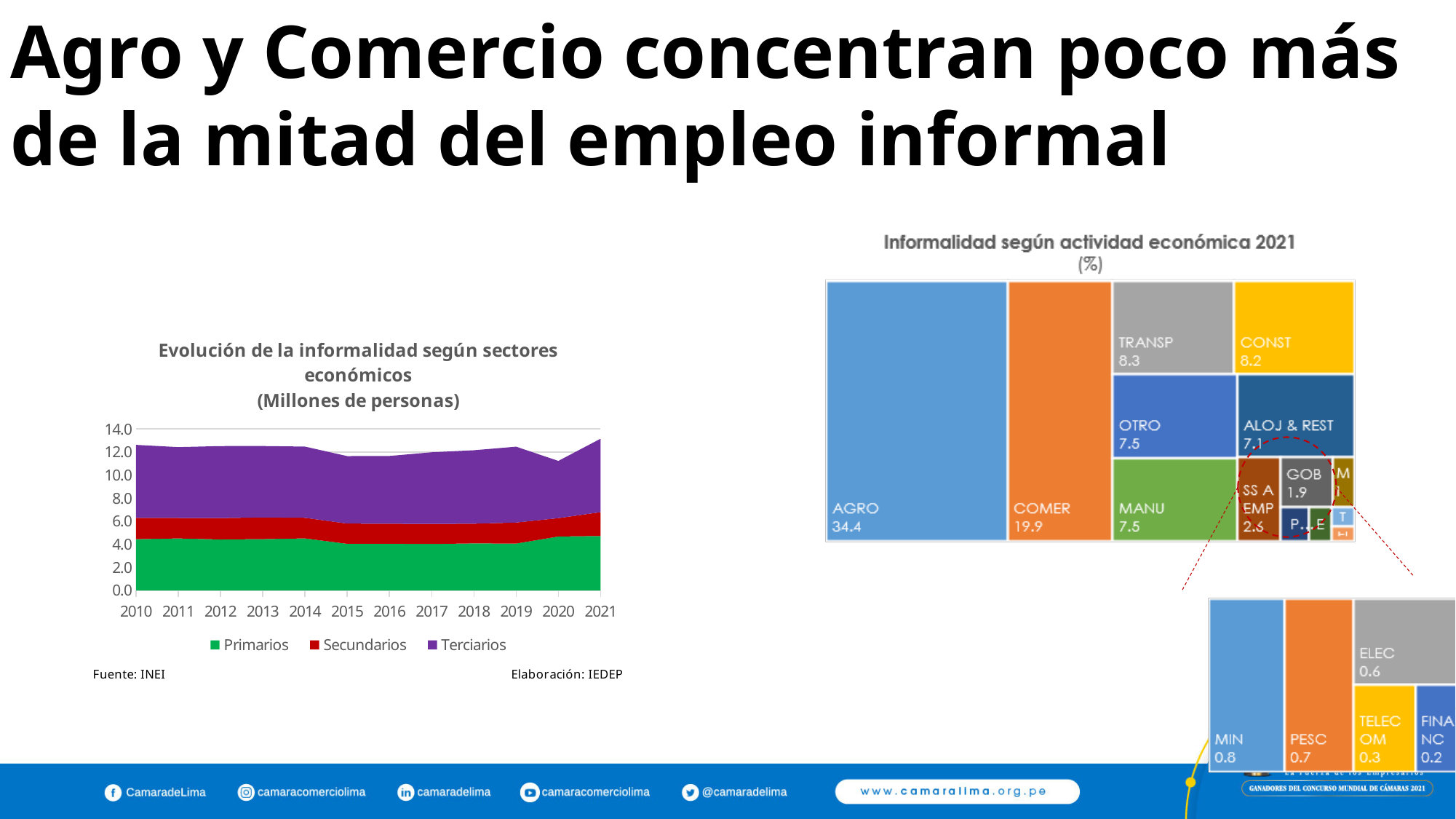
In the treemap 'Informalidad según actividad económica 2021 (%)', what is the value for GOB? 1.9 How many years are shown on the x axis of 'Evolución de la informalidad según sectores económicos'? 12 In the zoomed inset of the treemap at the bottom right, what is the value for MIN? 0.8 What kind of chart is 'Evolución de la informalidad según sectores económicos'? Stacked area chart In the treemap 'Informalidad según actividad económica 2021 (%)', what is the value for COMER? 19.9 In the treemap 'Informalidad según actividad económica 2021 (%)', what is the difference between AGRO and COMER? 14.5 In the treemap 'Informalidad según actividad económica 2021 (%)', what is the value for AGRO? 34.4 In the treemap 'Informalidad según actividad económica 2021 (%)', what is the combined value of AGRO and COMER? 54.3 In the treemap 'Informalidad según actividad económica 2021 (%)', which activity has the highest share? AGRO In the treemap 'Informalidad según actividad económica 2021 (%)', which is larger, TRANSP or CONST? TRANSP In the zoomed inset of the treemap at the bottom right, which activity has the lowest value? FINANC How many series does the legend of 'Evolución de la informalidad según sectores económicos' list? 3